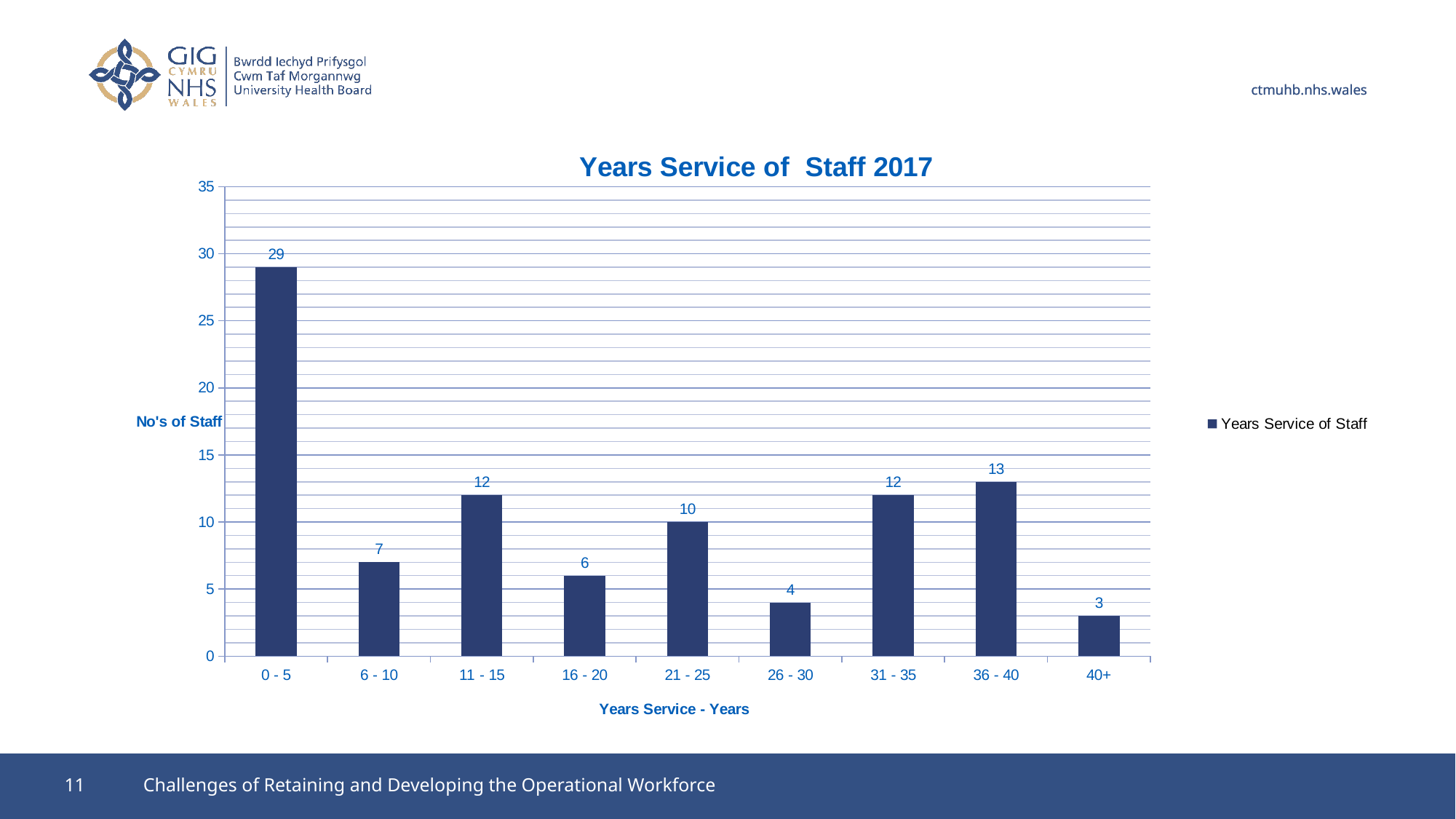
Is the value for 26 - 30 greater or less than 5? less Which category has more staff, 36 - 40 or 31 - 35? 36 - 40 What kind of chart is shown on the slide? Bar chart What is the title of the chart? Years Service of Staff 2017 What is the number of staff with 0 - 5 years of service? 29 How many series does the legend list? 1 Which years-of-service category has the highest number of staff? 0 - 5 What is the difference in number of staff between the 0 - 5 and 6 - 10 categories? 22 What is the number of staff with 21 - 25 years of service? 10 Which years-of-service category has the lowest number of staff? 40+ What is the number of staff with 40+ years of service? 3 How many years-of-service categories are shown on the x axis? 9